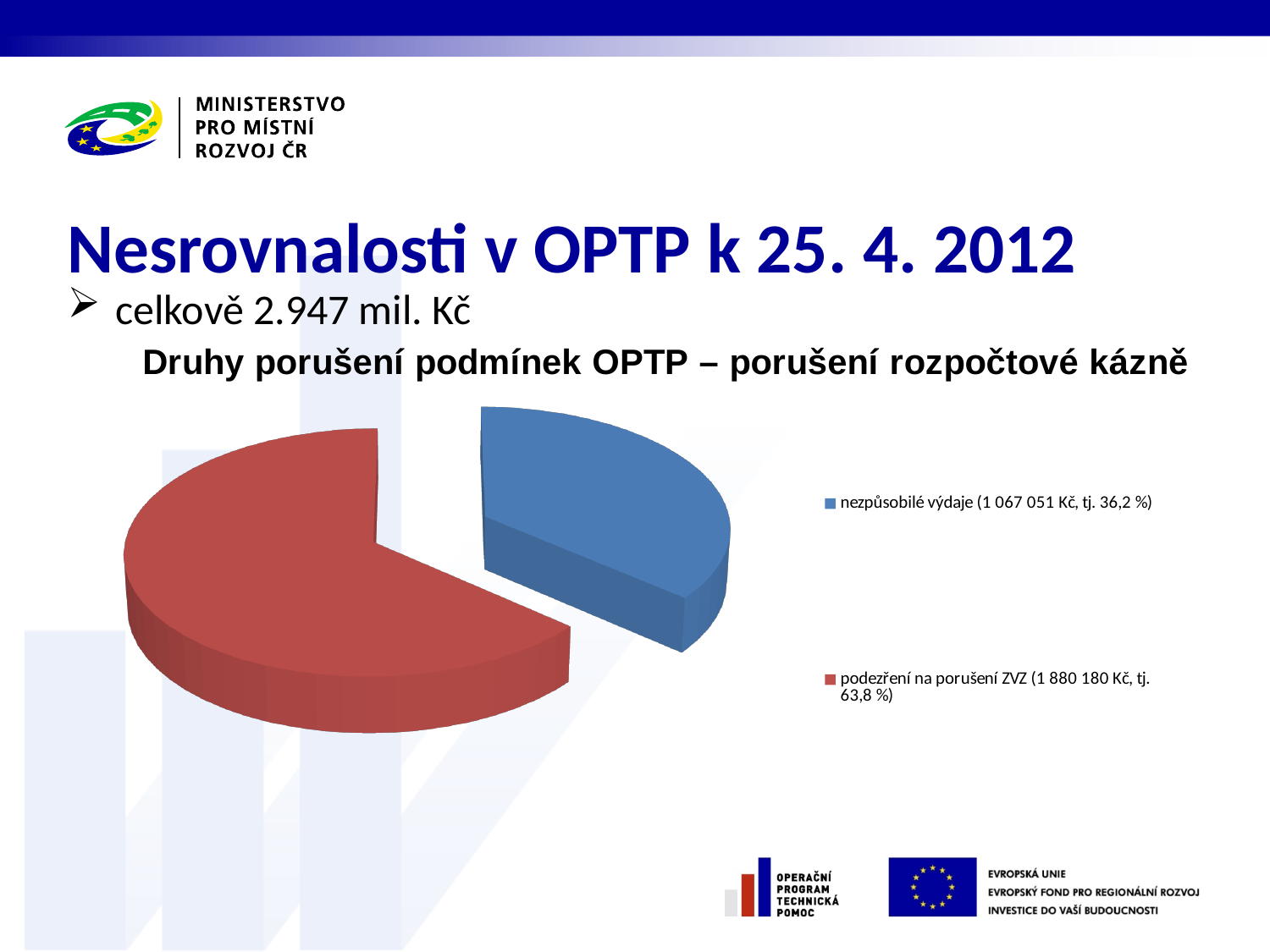
Which category has the smallest slice in the pie chart? nezpůsobilé výdaje What amount in Kč is given for nezpůsobilé výdaje in the pie chart legend? 1 067 051 Kč What amount in Kč is given for podezření na porušení ZVZ in the pie chart legend? 1 880 180 Kč What is the title of the pie chart? Druhy porušení podmínek OPTP – porušení rozpočtové kázně Which is larger in the pie chart: nezpůsobilé výdaje or podezření na porušení ZVZ? podezření na porušení ZVZ What share of the pie does podezření na porušení ZVZ represent? 63,8 % What kind of chart is shown on the slide? pie chart What share of the pie does nezpůsobilé výdaje represent? 36,2 % How many slices does the pie chart have? 2 How many entries does the legend of the pie chart list? 2 Which category has the largest slice in the pie chart? podezření na porušení ZVZ What colour is the slice for podezření na porušení ZVZ in the pie chart? red